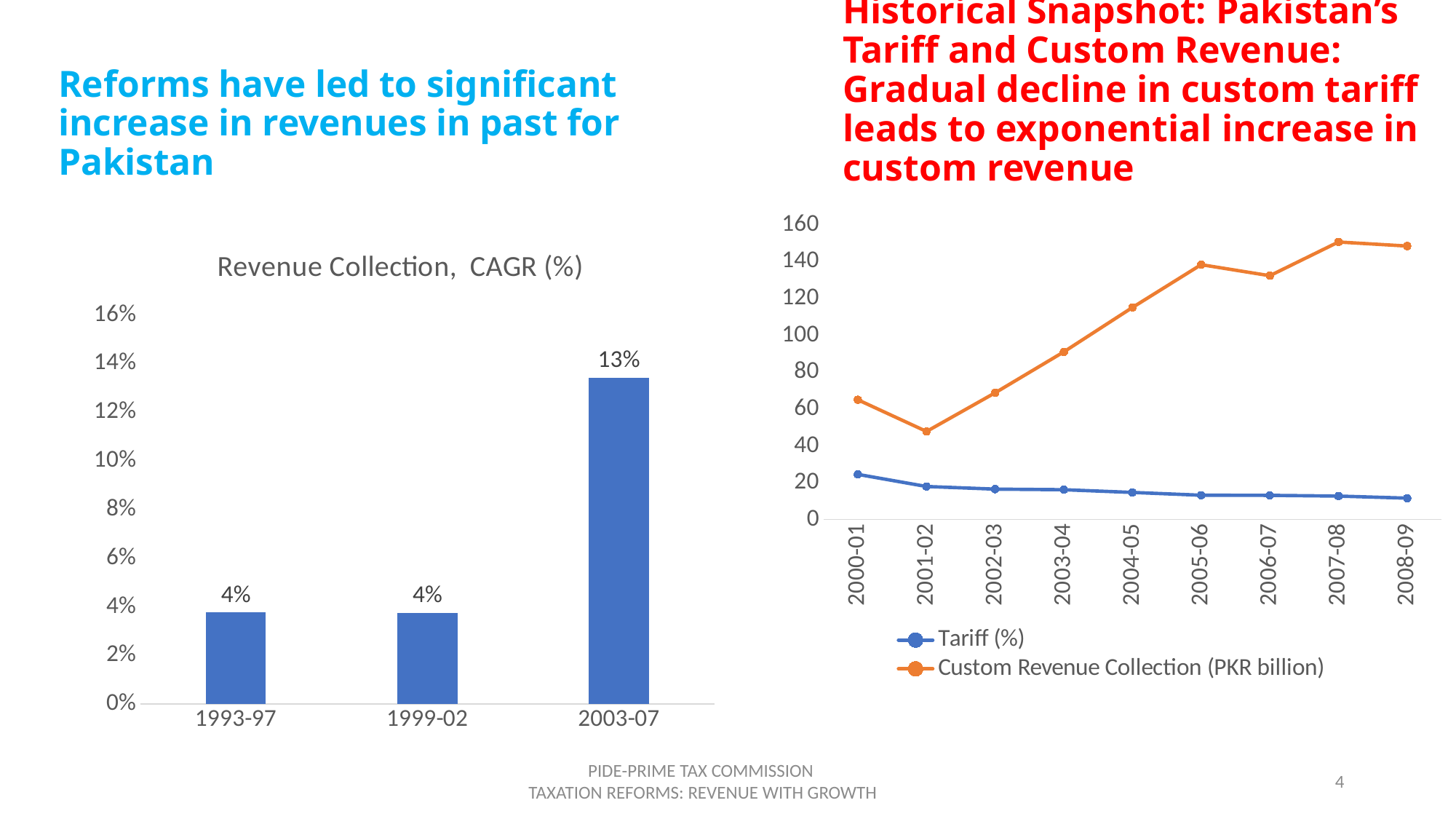
In the line chart on the right, is the value for Custom Revenue Collection (PKR billion) in 2007-08 greater or less than 140? greater In the bar chart titled 'Revenue Collection, CAGR (%)', what is the difference between the values for 2003-07 and 1999-02? 9% In the bar chart titled 'Revenue Collection, CAGR (%)', which period has the highest value? 2003-07 In the bar chart titled 'Revenue Collection, CAGR (%)', how many periods are shown? 3 In the line chart on the right, does the Tariff (%) series rise or fall from 2000-01 to 2008-09? fall In the line chart on the right, is the value for Tariff (%) in 2008-09 greater or less than 20? less In the line chart on the right, how many series does the legend list? 2 In the bar chart titled 'Revenue Collection, CAGR (%)', what is the value for 2003-07? 13% In the line chart on the right, is the value for Custom Revenue Collection (PKR billion) in 2001-02 greater or less than 60? less In the line chart on the right, how many years are shown on the x axis? 9 In the bar chart titled 'Revenue Collection, CAGR (%)', what is the value for 1993-97? 4% What kind of chart is the chart titled 'Revenue Collection, CAGR (%)'? bar chart